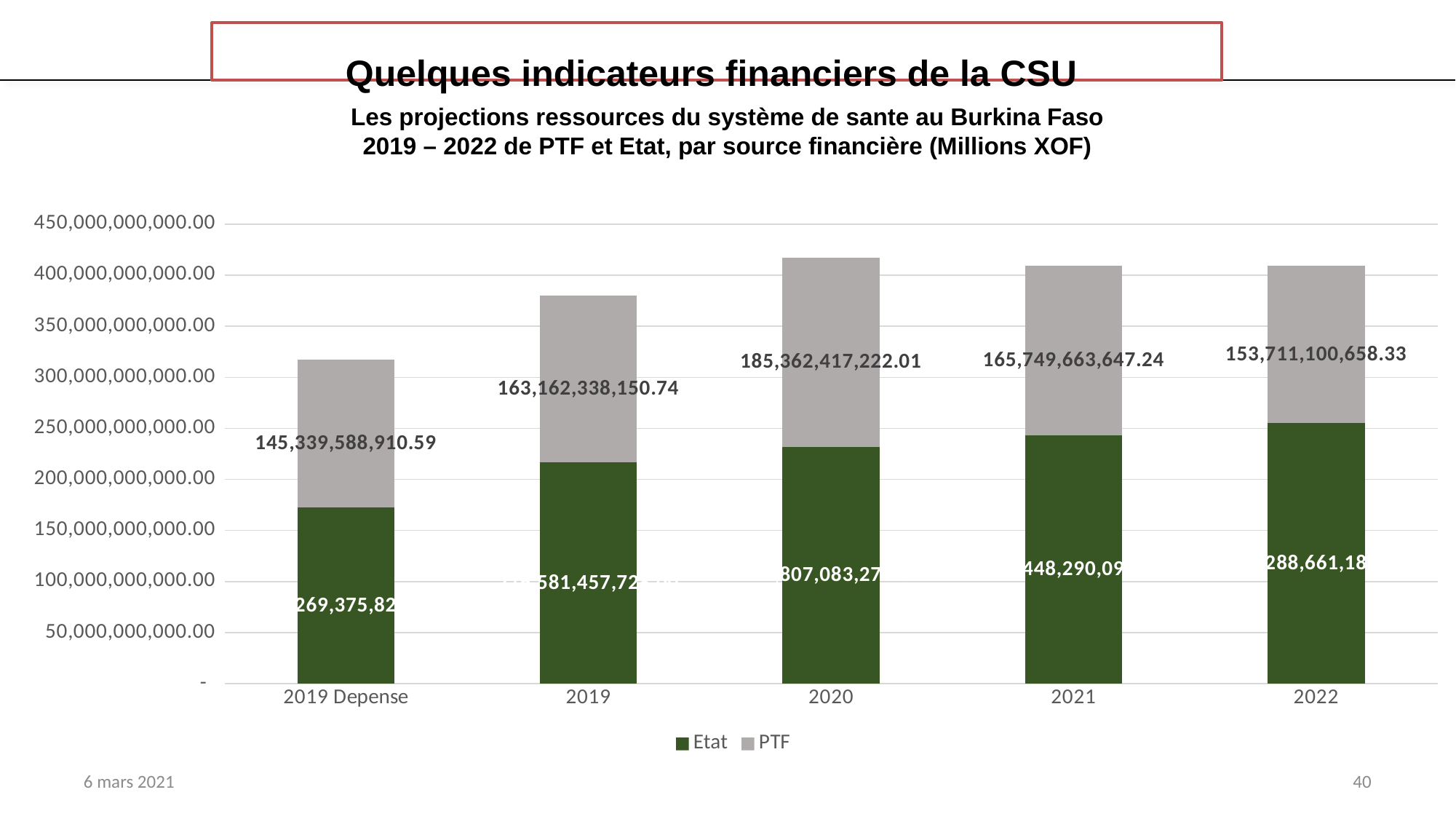
What is the PTF value for 2019 Depense? 145,339,588,910.59 How many series does the legend list? 2 Which category has the highest PTF value? 2020 Which category has the lowest PTF value? 2019 Depense Which has the larger PTF value, 2019 or 2022? 2019 Is the Etat value for 2020 greater or less than 200,000,000,000.00? greater What kind of chart is this? Stacked bar chart What is the difference between the PTF values for 2020 and 2021? 19,612,753,574.77 What is the PTF value for 2020? 185,362,417,222.01 How many categories are shown on the x axis? 5 What is the PTF value for 2022? 153,711,100,658.33 Is the Etat value for 2019 Depense greater or less than 200,000,000,000.00? less